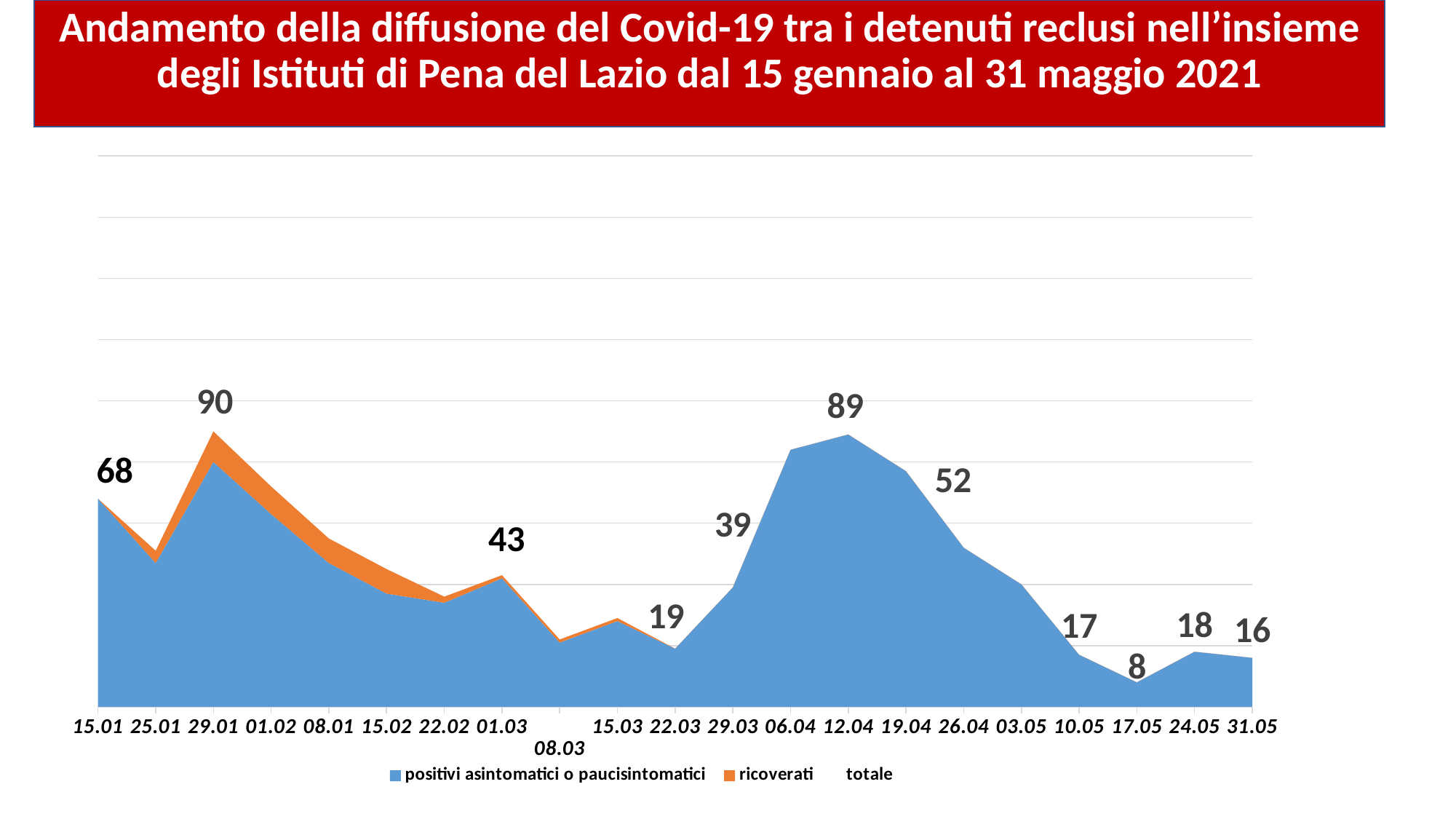
How many series does the legend list? 3 What kind of chart is shown on the slide? Area chart Which date has the highest labelled total value? 29.01 What is the total value labelled for 29.01? 90 Do the labelled total values rise or fall from 12.04 to 17.05? Fall Which is larger, the labelled total for 15.01 or for 01.03? 15.01 How many dates are shown on the x axis? 21 What is the total value labelled for 31.05? 16 What is the total value labelled for 12.04? 89 Which date has the lowest labelled total value? 17.05 What is the total value labelled for 17.05? 8